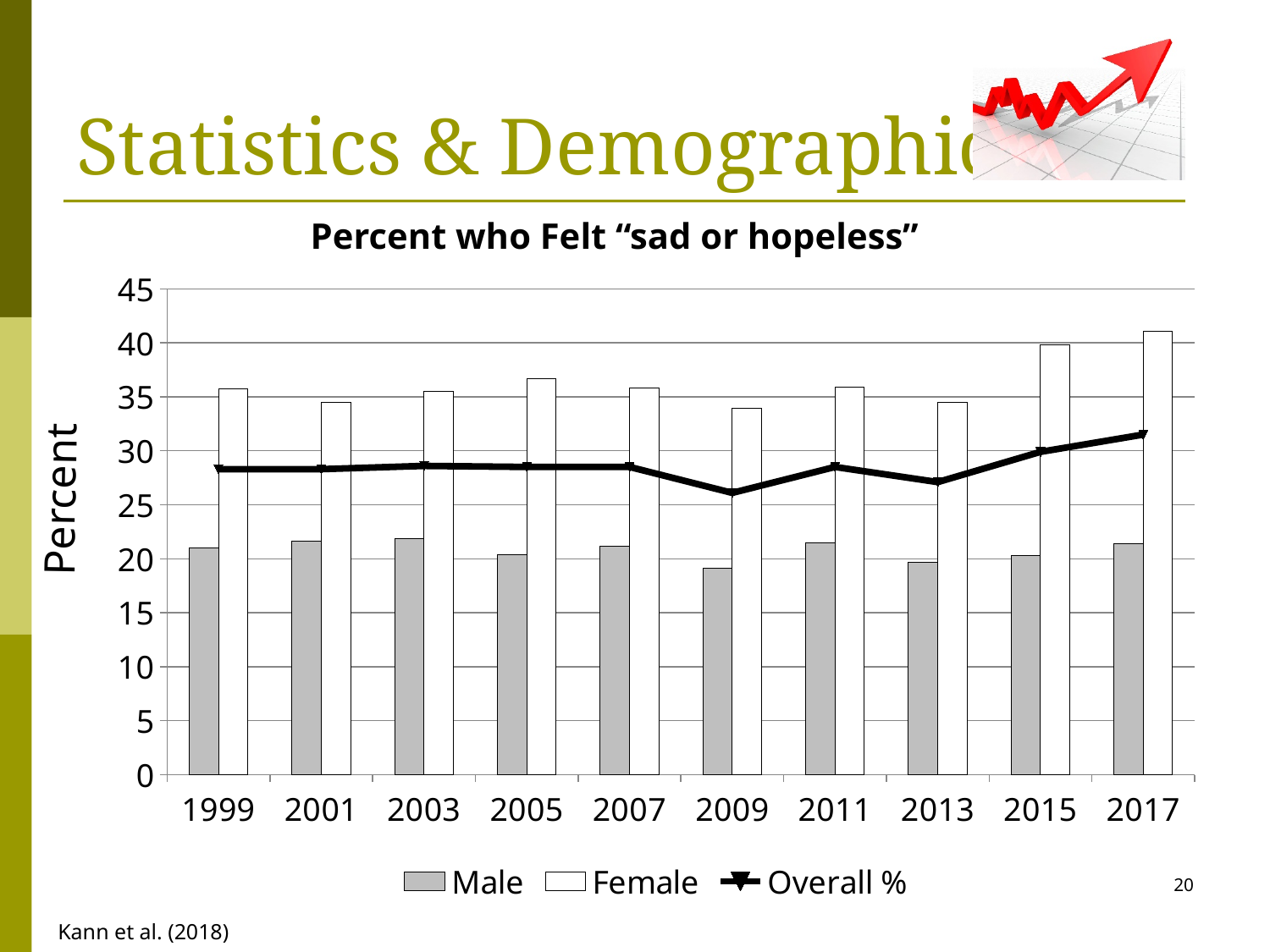
Is the Overall % value for 2017 greater or less than 30? greater In which year is the Female value highest? 2017 In which year is the Overall % value lowest? 2009 How many series does the legend list? 3 What is the title of the chart? Percent who Felt "sad or hopeless" Which is larger in 2013, the Male value or the Female value? Female Is the Male value for 2009 greater or less than 20? less How many years are shown on the x axis? 10 What kind of chart is shown on the slide? bar chart (with an overlaid line) Is the Female value for 2017 greater or less than 40? greater Does the Overall % line rise or fall from 2013 to 2017? rise In which year is the Overall % value highest? 2017